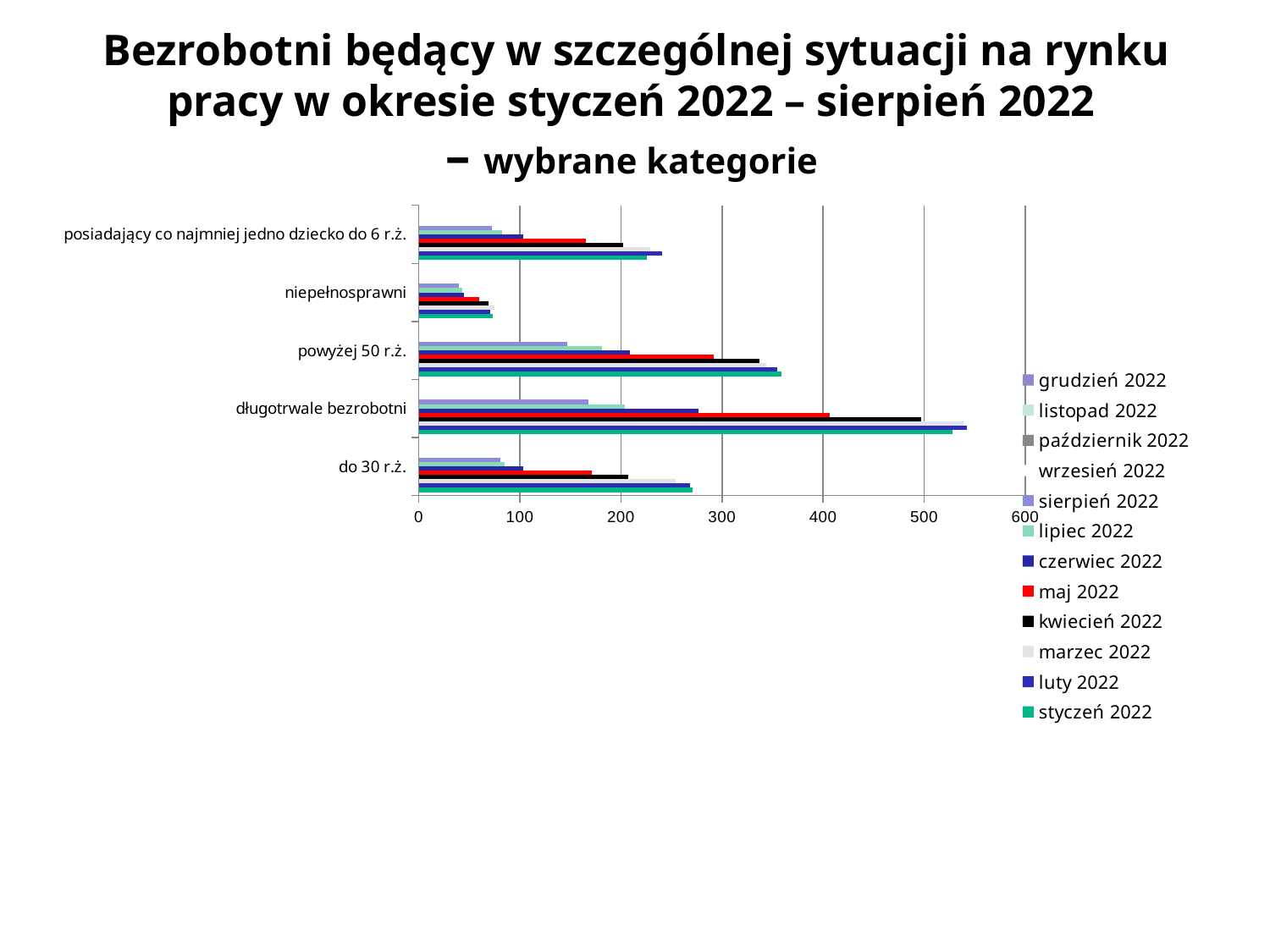
For maj 2022, which category has the lowest value? niepełnosprawni How many series does the legend list? 12 How many categories are shown on the vertical axis of the chart? 5 Is the value for powyżej 50 r.ż. in kwiecień 2022 greater or less than 300? greater Is the value for długotrwale bezrobotni in styczeń 2022 greater or less than 500? greater Is the value for niepełnosprawni in maj 2022 greater or less than 100? less For styczeń 2022, which is larger: the value for długotrwale bezrobotni or the value for niepełnosprawni? długotrwale bezrobotni Which series is listed first in the chart legend? grudzień 2022 For styczeń 2022, which category has the highest value? długotrwale bezrobotni What kind of chart is shown on the slide? bar chart